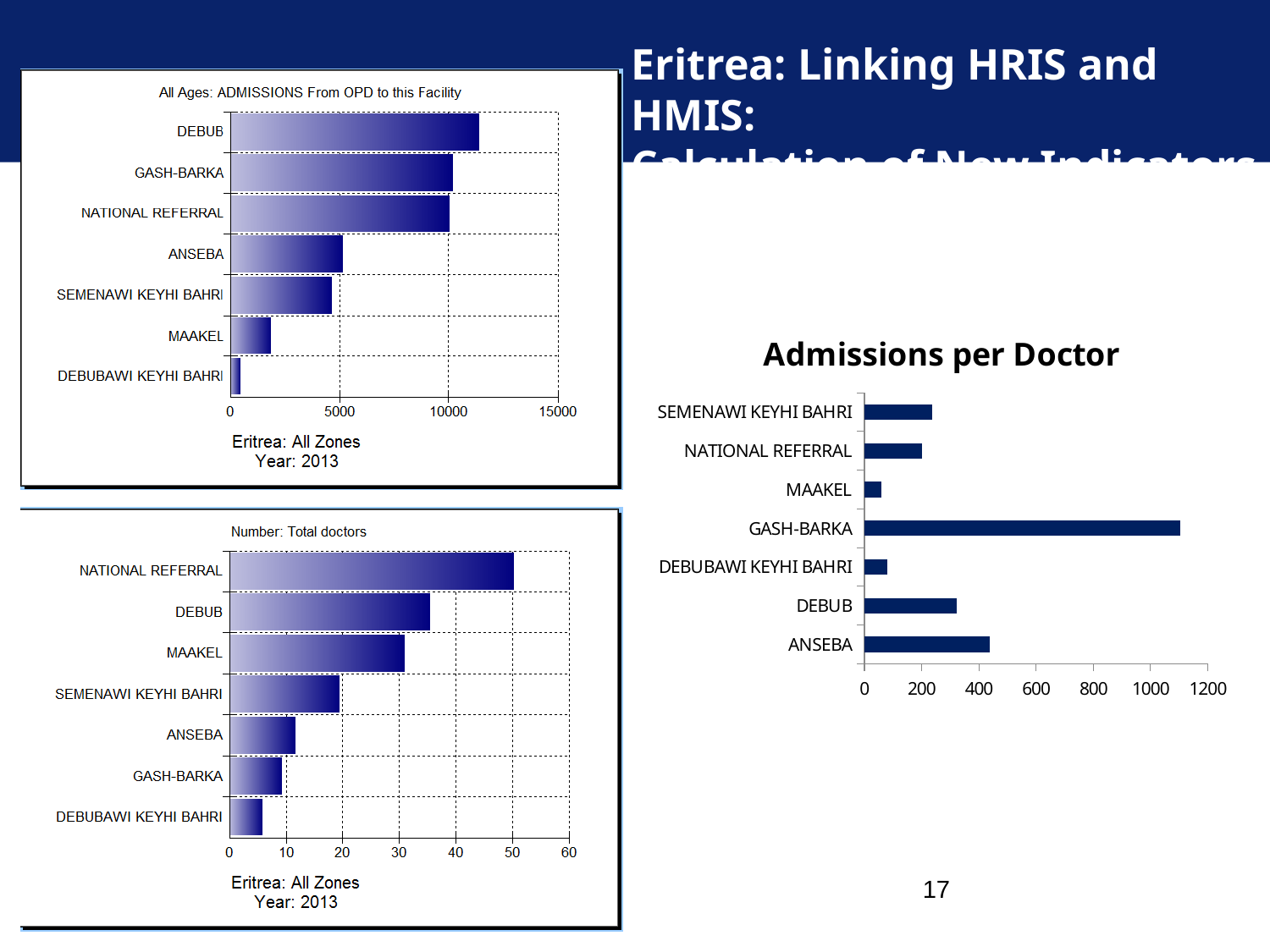
In the 'All Ages: ADMISSIONS From OPD to this Facility' chart, which zone has the highest value? DEBUB How many zones are shown in the 'Admissions per Doctor' chart? 7 In the 'Admissions per Doctor' chart, which zone has the highest value? GASH-BARKA What kind of chart is the 'Admissions per Doctor' chart? Bar chart In the 'Admissions per Doctor' chart, is the value for ANSEBA greater or less than 400? greater In the 'All Ages: ADMISSIONS From OPD to this Facility' chart, which zone has the lowest value? DEBUBAWI KEYHI BAHRI In the 'All Ages: ADMISSIONS From OPD to this Facility' chart, is the value for DEBUB greater or less than 10000? greater In the 'Admissions per Doctor' chart, is the value for GASH-BARKA greater or less than 1000? greater In the 'Number: Total doctors' chart, which zone has the highest value? NATIONAL REFERRAL In the 'Admissions per Doctor' chart, which is larger, the value for DEBUB or the value for NATIONAL REFERRAL? DEBUB What year is shown beneath the 'Number: Total doctors' chart? 2013